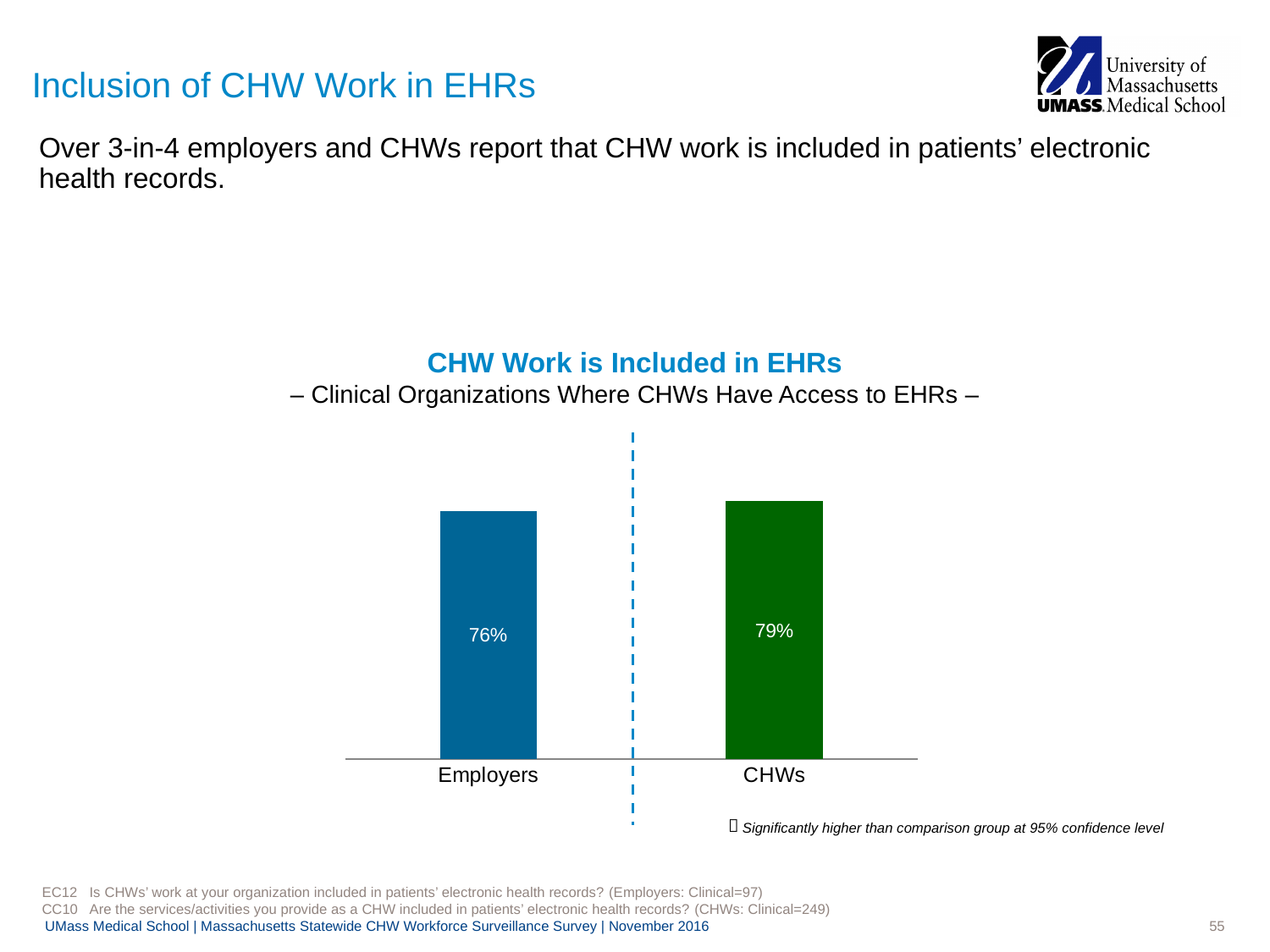
How many categories are shown in the chart? 2 What kind of chart is shown on the slide? Bar chart What is the title of the chart? CHW Work is Included in EHRs What is the value for Employers? 76% Which is larger, the value for Employers or the value for CHWs? CHWs Which category has the highest value? CHWs What is the value for CHWs? 79% What is the difference between the CHWs value and the Employers value? 3% What colour is the bar for CHWs? Green Which category has the lowest value? Employers